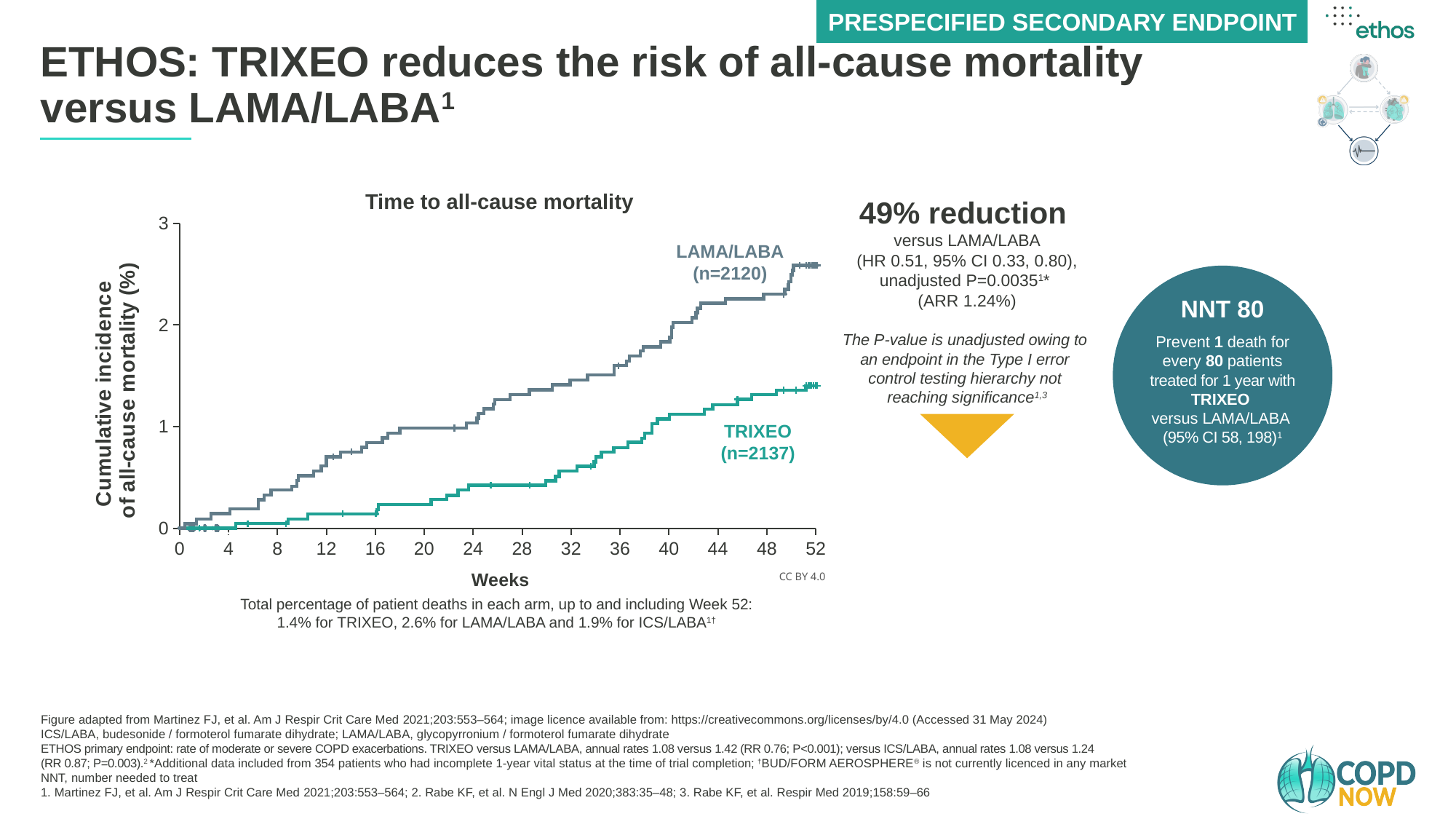
What is the number of patients (n) shown for the TRIXEO series? 2137 Which series has the higher cumulative incidence of all-cause mortality at Week 52, TRIXEO or LAMA/LABA? LAMA/LABA What is the label of the x axis of the chart? Weeks What kind of chart is shown under the title 'Time to all-cause mortality'? line chart Is the cumulative incidence for TRIXEO at Week 52 greater or less than 2? less What is the cumulative incidence of all-cause mortality for TRIXEO at Week 52? 1.4% Is the cumulative incidence for LAMA/LABA at Week 52 greater or less than 2? greater What is the cumulative incidence of all-cause mortality for LAMA/LABA at Week 52? 2.6% Is the cumulative incidence for TRIXEO at Week 32 greater or less than 1? less Which series reaches the highest cumulative incidence of all-cause mortality in the chart? LAMA/LABA How many series are plotted in the 'Time to all-cause mortality' chart? 2 Do the cumulative incidence curves rise or fall as the weeks increase? rise